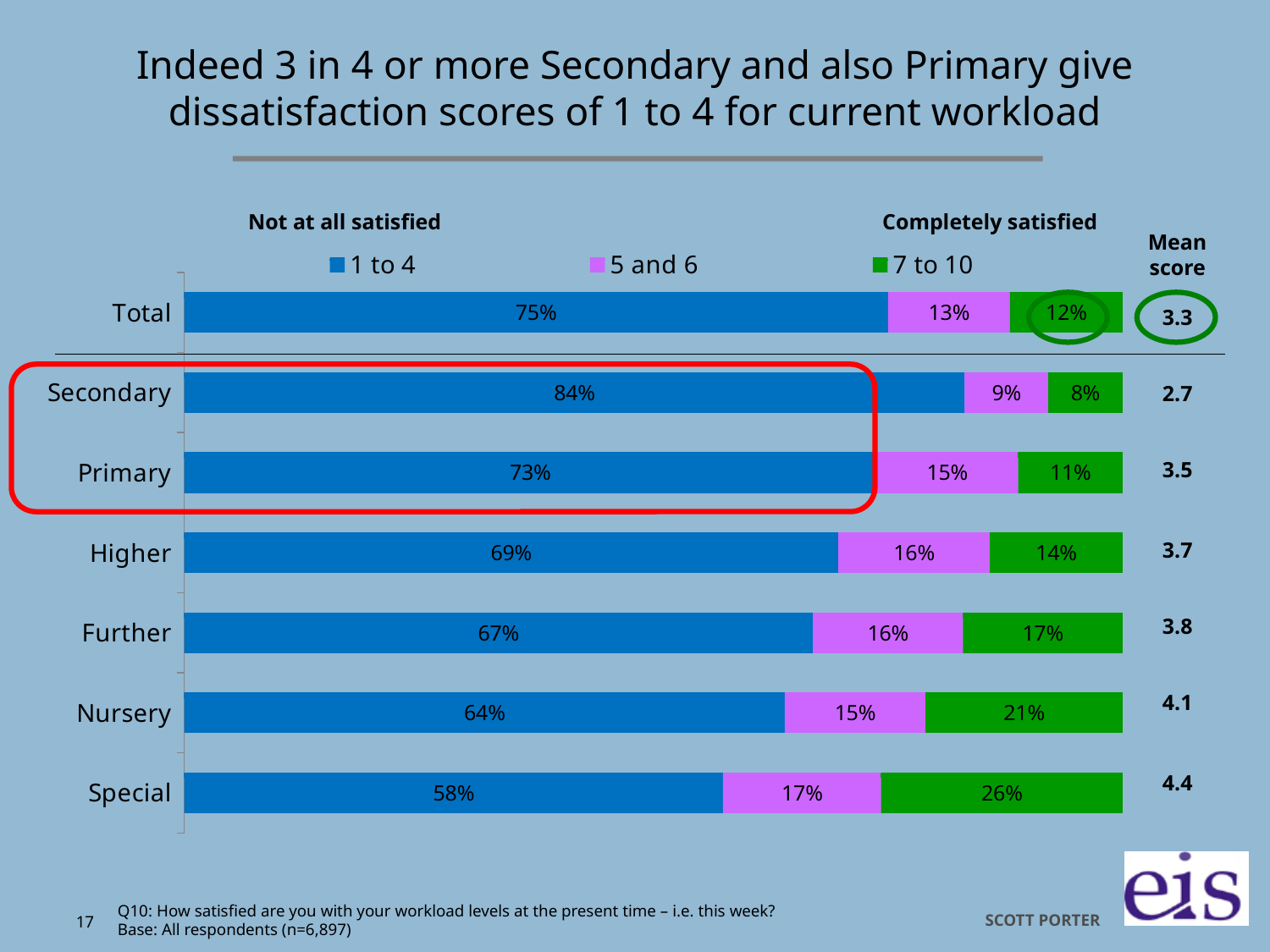
What percentage of Secondary respondents gave a score of 1 to 4? 84% How many series does the legend list? 3 Which is larger: the 7 to 10 percentage for Nursery or for Further? Nursery What percentage of Nursery respondents gave a score of 5 and 6? 15% Which colour represents the '7 to 10' series in the legend? Green How many categories (rows) are shown in the chart, including Total? 7 What is the difference between the 1 to 4 percentages for Secondary and Primary? 11 percentage points What kind of chart is shown on the slide? Stacked bar chart Which category has the lowest percentage giving a score of 7 to 10? Secondary What percentage of Special respondents gave a score of 7 to 10? 26% What is the mean score shown for Primary? 3.5 Which category has the highest percentage giving a score of 1 to 4? Secondary